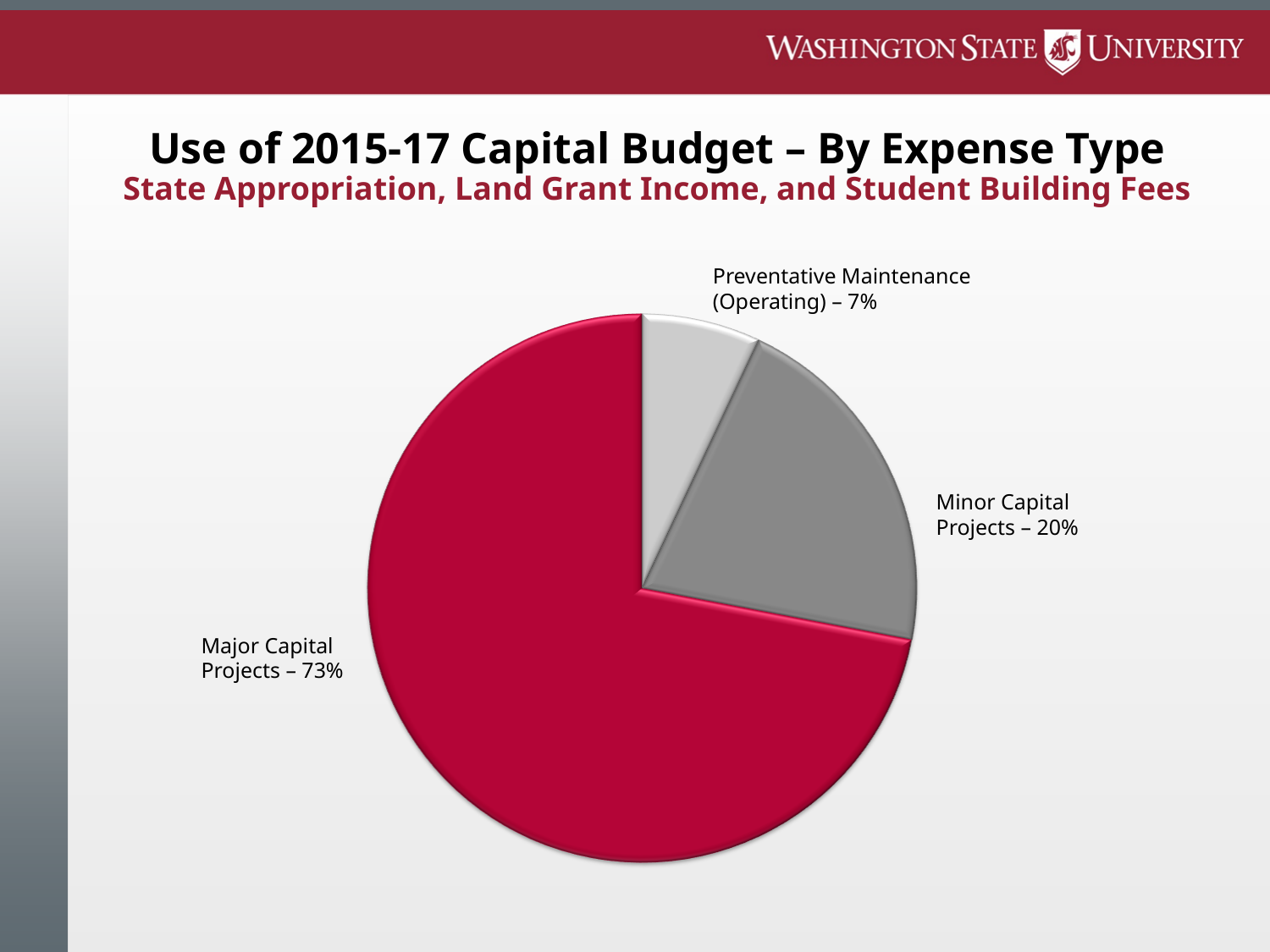
How many percentage points larger is the Minor Capital Projects share than the Preventative Maintenance (Operating) share? 13 What share of the 2015-17 capital budget goes to Major Capital Projects? 73% Which has a larger share of the capital budget, Minor Capital Projects or Preventative Maintenance (Operating)? Minor Capital Projects What colour is the Major Capital Projects slice of the pie chart? Red (crimson) What share of the 2015-17 capital budget goes to Minor Capital Projects? 20% How many percentage points larger is the Major Capital Projects share than the Minor Capital Projects share? 53 What kind of chart is shown on the slide? Pie chart What share of the 2015-17 capital budget goes to Preventative Maintenance (Operating)? 7% Which expense type has the smallest share of the 2015-17 capital budget? Preventative Maintenance (Operating) What is the title of the chart on the slide? Use of 2015-17 Capital Budget – By Expense Type How many expense types are shown in the pie chart? 3 Which expense type has the largest share of the 2015-17 capital budget? Major Capital Projects